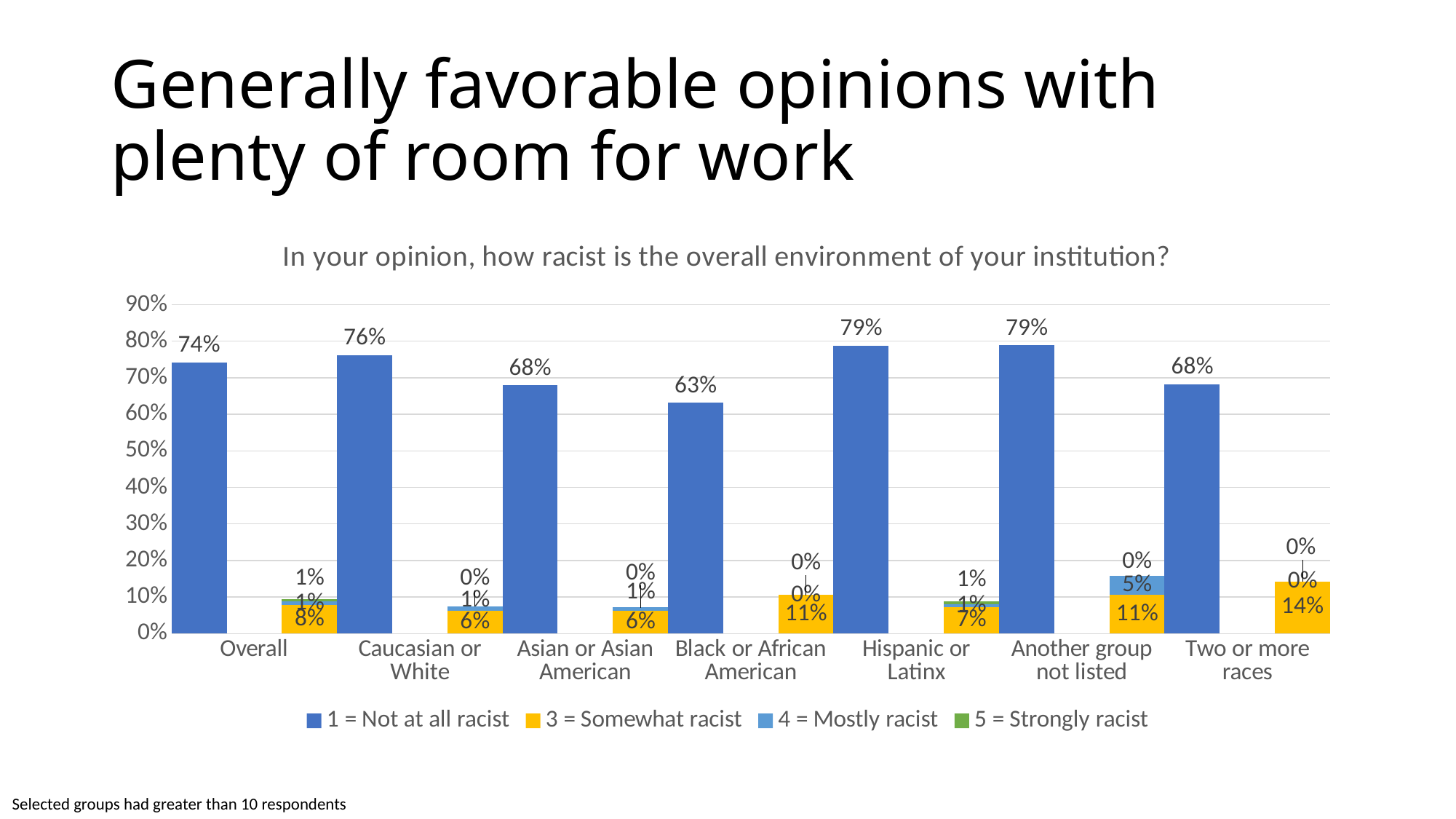
What is the difference between the 1 = Not at all racist values for Caucasian or White and Black or African American? 13 percentage points Which category has the lowest value for 1 = Not at all racist? Black or African American What is the 4 = Mostly racist value for the Another group not listed category? 5% What percentage of Overall respondents rated their institution as 1 = Not at all racist? 74% What percentage of Two or more races respondents chose 3 = Somewhat racist? 14% How many categories are shown on the x axis of the chart? 7 What type of chart is shown on the slide? Bar chart What is the value for 1 = Not at all racist among Black or African American respondents? 63% Is the 1 = Not at all racist value for Black or African American greater or less than 60%? greater Which has a higher 1 = Not at all racist value: Hispanic or Latinx or Asian or Asian American? Hispanic or Latinx How many series does the chart legend list? 4 Which category has the highest value for 3 = Somewhat racist? Two or more races